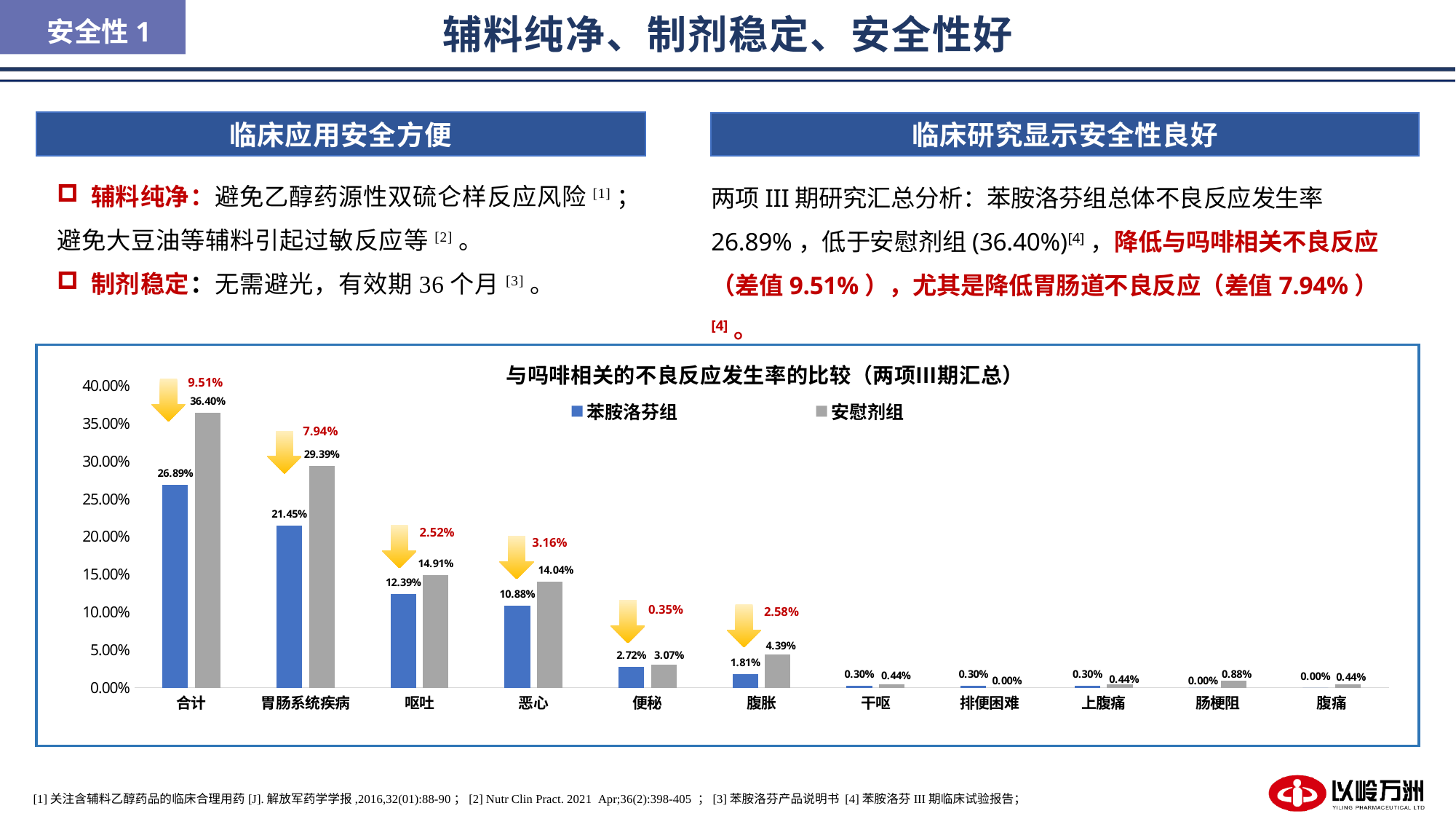
What type of chart is shown on the slide? Bar chart Which category has the highest value for 安慰剂组? 合计 What is the value for 苯胺洛芬组 in the 腹胀 category? 1.81% What is the value for 安慰剂组 in the 胃肠系统疾病 category? 29.39% What is the difference between 安慰剂组 and 苯胺洛芬组 in the 呕吐 category? 2.52% What is the value for 苯胺洛芬组 in the 合计 category? 26.89% How many categories are shown on the x axis of the chart? 11 How many series does the chart legend list? 2 What is the value for 安慰剂组 in the 肠梗阻 category? 0.88% In the 排便困难 category, which series has the larger value, 苯胺洛芬组 or 安慰剂组? 苯胺洛芬组 What is the difference between 安慰剂组 and 苯胺洛芬组 in the 恶心 category? 3.16% In the 便秘 category, which series has the larger value, 苯胺洛芬组 or 安慰剂组? 安慰剂组